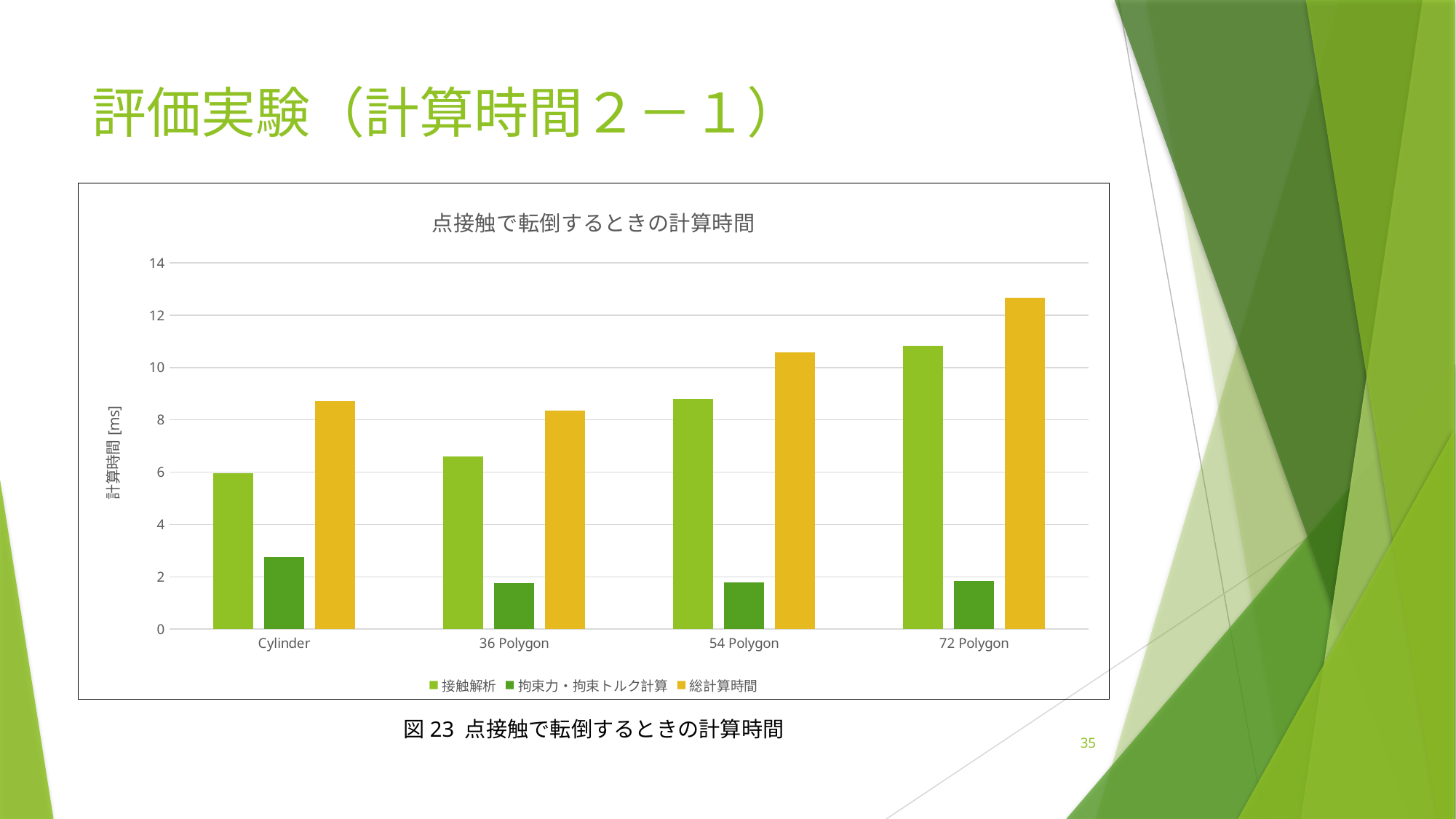
Is the value of 接触解析 for 54 Polygon greater or less than 8? greater Which category has the lowest value for 接触解析? Cylinder Which category has the highest value for 拘束力・拘束トルク計算? Cylinder How many series does the chart's legend list? 3 What kind of chart is shown on the slide? Bar chart Is the value of 拘束力・拘束トルク計算 for 36 Polygon greater or less than 2? less Do the 接触解析 values rise or fall from Cylinder to 72 Polygon? rise Which is larger: the 接触解析 value for 36 Polygon or for 54 Polygon? 54 Polygon Which category has the highest value for 総計算時間? 72 Polygon What is the title of the chart? 点接触で転倒するときの計算時間 How many categories are shown on the x axis of the chart? 4 Is the value of 総計算時間 for 72 Polygon greater or less than 12? greater